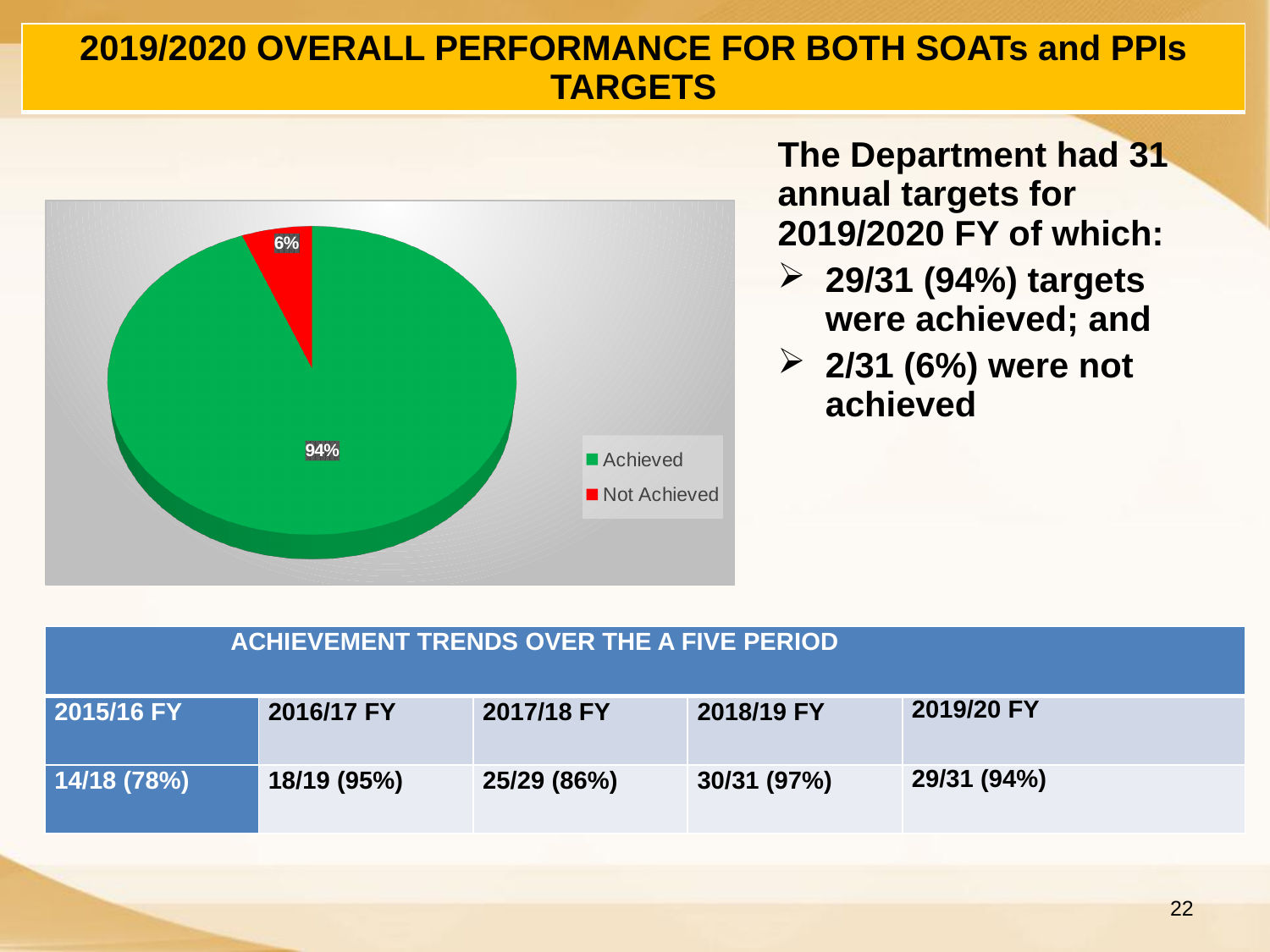
Which slice of the pie chart is the largest? Achieved What colour is the Not Achieved slice in the pie chart? Red How many slices does the pie chart have? 2 What colour is the Achieved slice in the pie chart? Green Which slice of the pie chart is the smallest? Not Achieved How many entries does the pie chart legend list? 2 What is the difference in percentage points between the Achieved and Not Achieved slices? 88 What type of chart is shown on the slide? Pie chart Which is larger in the pie chart, Achieved or Not Achieved? Achieved What percentage of targets does the pie chart show as Not Achieved? 6% What percentage of targets does the pie chart show as Achieved? 94% What share of the pie does the Achieved slice represent? 94%